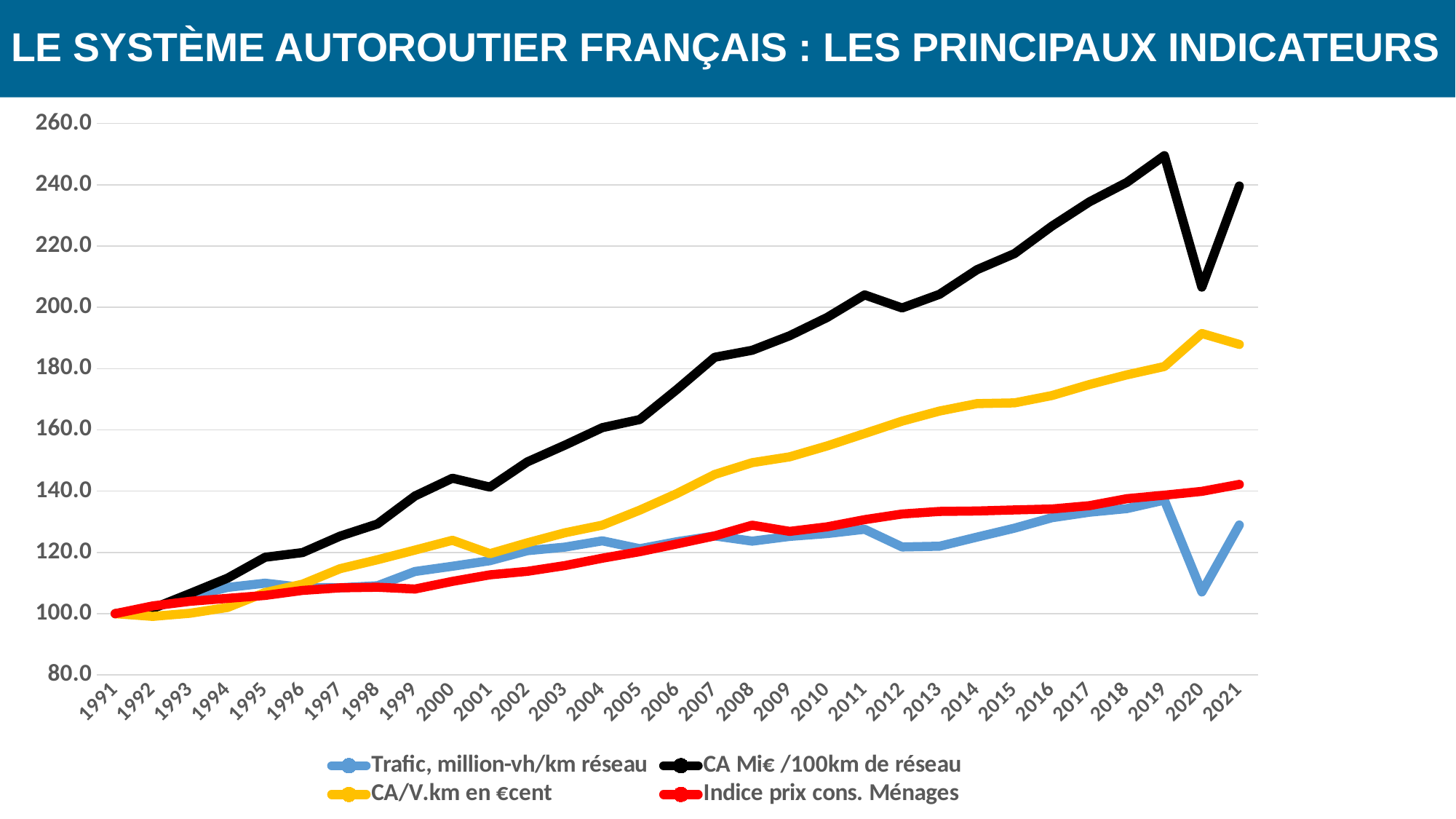
How many series does the legend list? 4 Is the value for Trafic, million-vh/km réseau in 2020 greater or less than 120? less Which series has the highest value in 2021? CA Mi€ /100km de réseau Is the value for CA Mi€ /100km de réseau in 2019 greater or less than 240? greater Is the value for CA Mi€ /100km de réseau in 2020 greater or less than 220? less What kind of chart is shown on the slide? line chart How many years are plotted along the x axis? 31 In 2021, which is larger: CA/V.km en €cent or Indice prix cons. Ménages? CA/V.km en €cent What is the title of the slide? LE SYSTÈME AUTOROUTIER FRANÇAIS : LES PRINCIPAUX INDICATEURS Does the CA/V.km en €cent series generally rise or fall from 1991 to 2021? rise Which series has the lowest value in 2020? Trafic, million-vh/km réseau